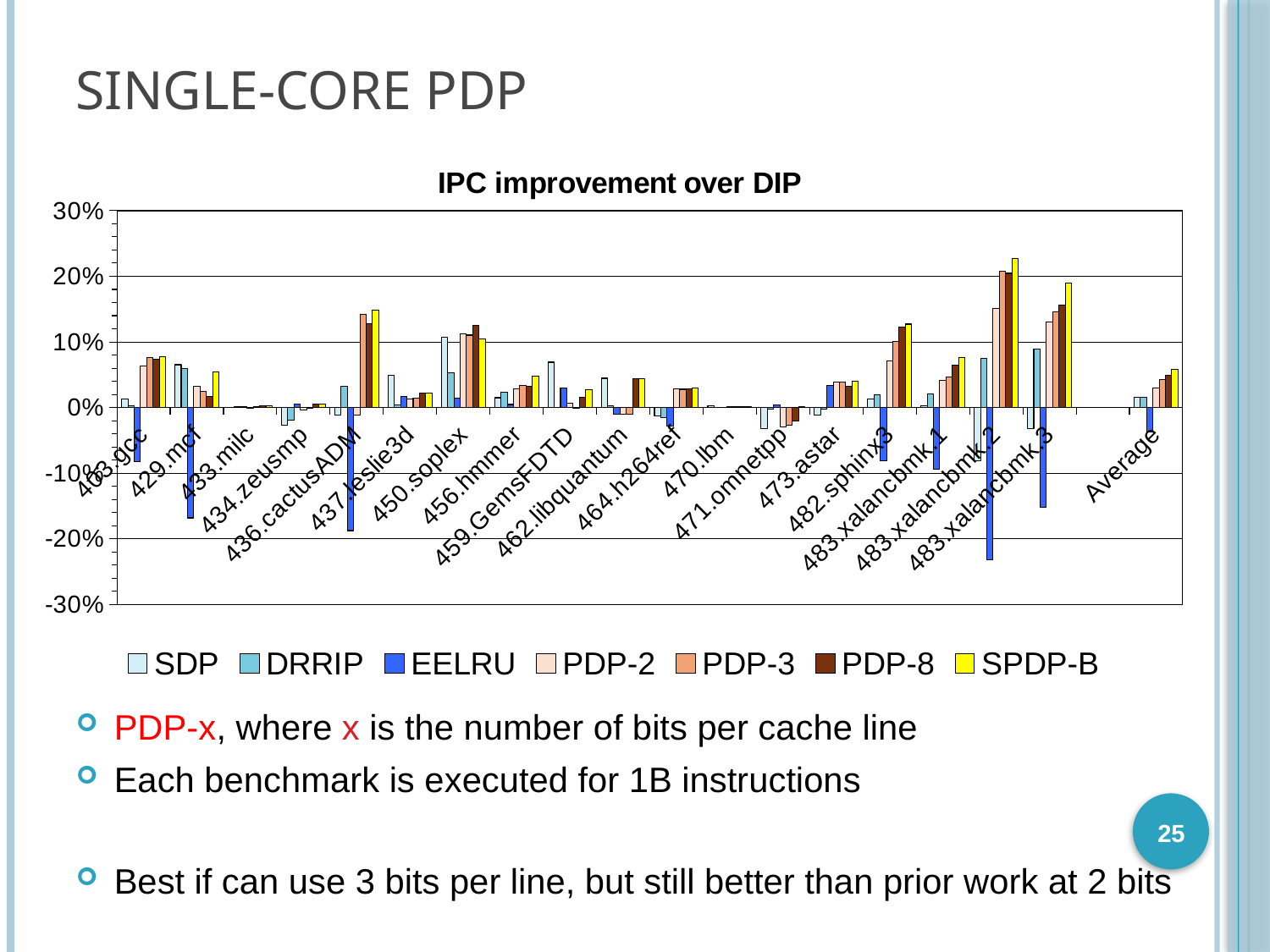
Is the SPDP-B value for 436.cactusADM greater or less than 10%? greater How many series does the legend list? 7 How many categories are shown along the x axis of the chart? 19 Is the SPDP-B value for Average greater or less than 10%? less Is the SPDP-B value for 483.xalancbmk.2 greater or less than 20%? greater Which category has the highest SPDP-B bar? 483.xalancbmk.2 What kind of chart is shown on the slide? bar chart What is the title of the chart? IPC improvement over DIP Which category has the lowest EELRU bar? 483.xalancbmk.2 Which series is listed last in the legend? SPDP-B